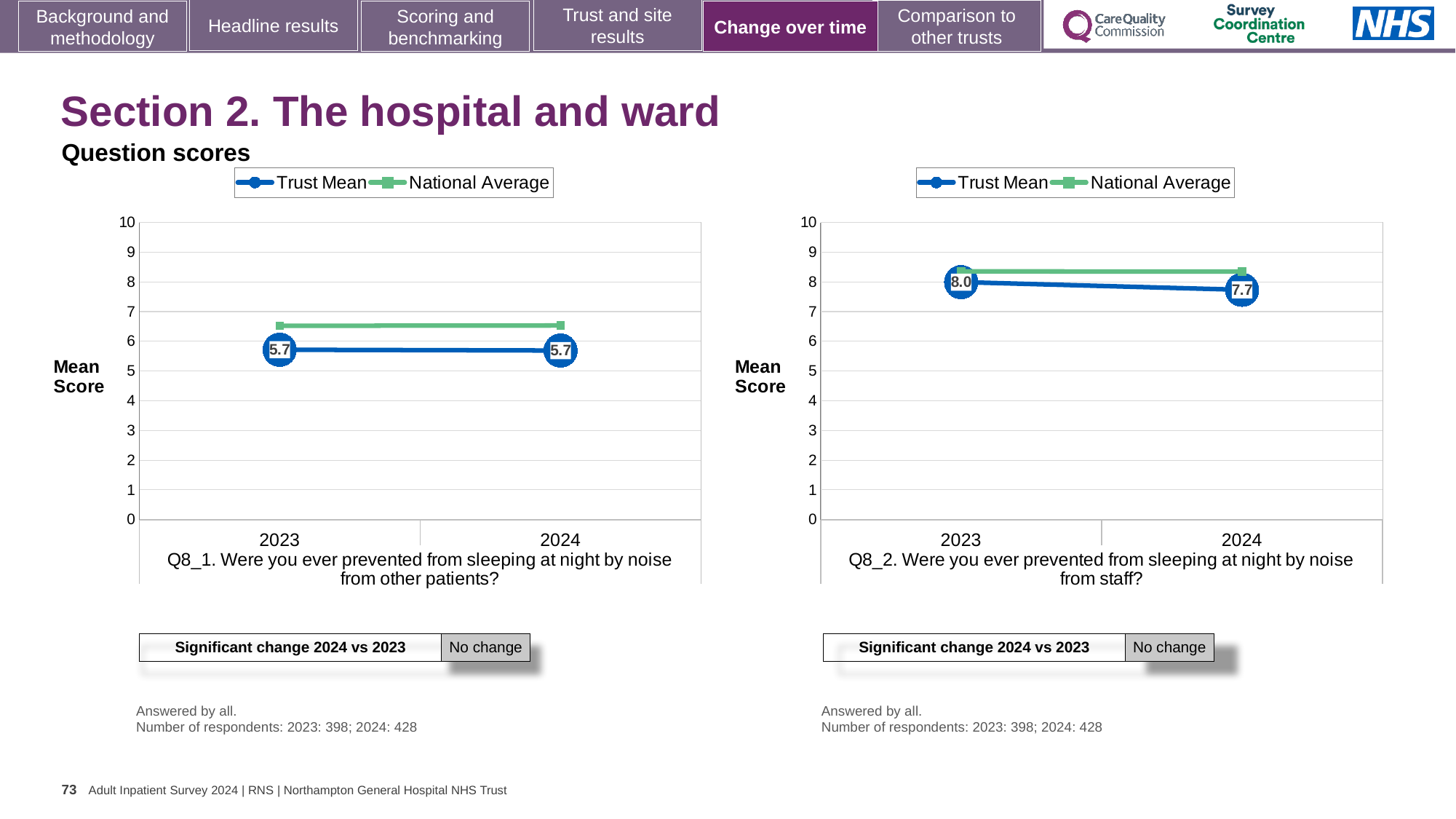
In the Q8_1 chart (left), what is the Trust Mean score for 2023? 5.7 In the Q8_1 chart (left), which series is higher in 2024, Trust Mean or National Average? National Average In the Q8_2 chart (right), is the National Average for 2023 greater or less than 8? greater In the Q8_1 chart (left), is the National Average for 2024 greater or less than 6? greater In the Q8_2 chart (right), what is the Trust Mean score for 2024? 7.7 In the Q8_1 chart (left), what is the Trust Mean score for 2024? 5.7 How many series does the legend of the Q8_2 chart (right) list? 2 How many years are plotted on the x axis of the Q8_1 chart (left)? 2 In the Q8_2 chart (right), by how much did the Trust Mean change from 2023 to 2024? decreased by 0.3 In the Q8_2 chart (right), what is the Trust Mean score for 2023? 8.0 In the Q8_2 chart (right), does the Trust Mean rise or fall from 2023 to 2024? fall What type of chart is the Q8_1 chart (left)? line chart